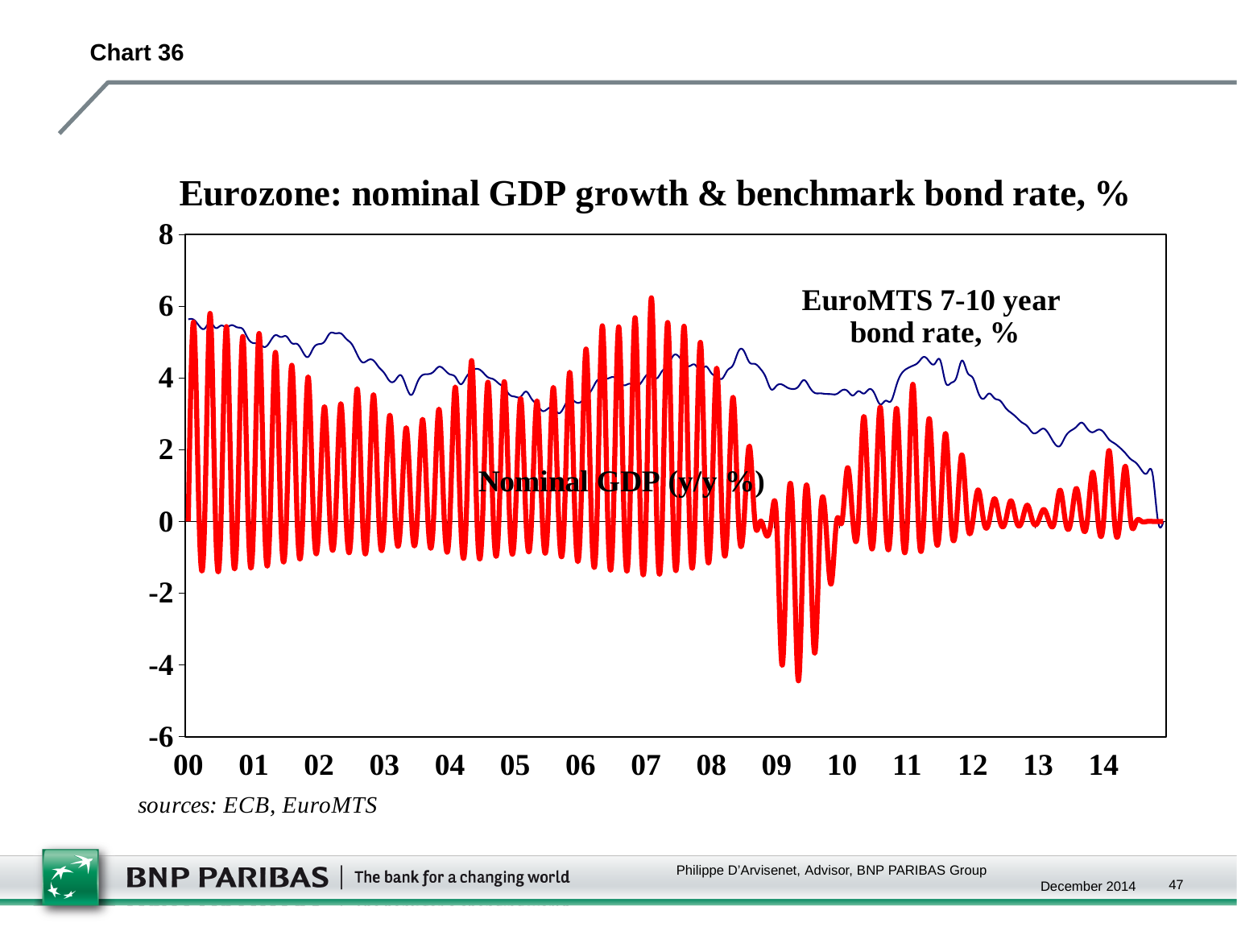
What kind of chart is shown on the slide? line chart In which year does Nominal GDP (y/y %) reach its lowest point? 09 Does the EuroMTS 7-10 year bond rate generally rise or fall from 2000 to 2014? fall During 2013, which series is higher: the EuroMTS 7-10 year bond rate or Nominal GDP (y/y %)? EuroMTS 7-10 year bond rate Is the EuroMTS 7-10 year bond rate at the start of 2000 greater or less than 4? greater How many series are plotted on the chart? 2 How many year labels are shown on the x axis? 15 Is the lowest value of Nominal GDP (y/y %) in 2009 greater or less than -4? less Is the peak of Nominal GDP (y/y %) in 2007 greater or less than 5? greater What is the title of the chart? Eurozone: nominal GDP growth & benchmark bond rate, % What colour is the Nominal GDP (y/y %) line? red